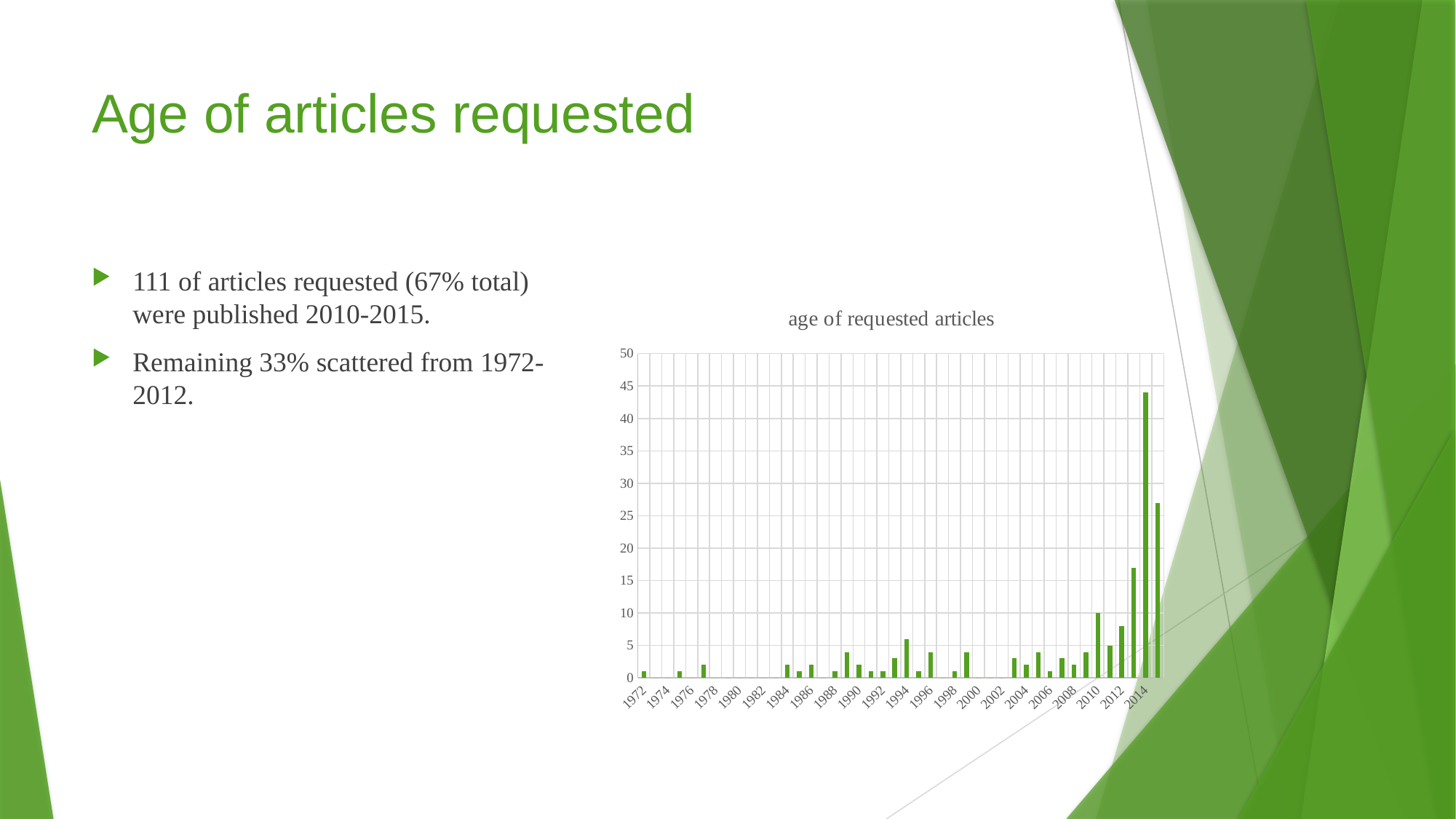
What kind of chart is shown on the slide? bar chart Which year has the highest number of requested articles? 2014 Is the value for 2013 greater or less than 15? greater What is the title of the chart? age of requested articles Do the values generally rise or fall as the years move from 1972 toward 2015? rise Is the value for 2015 greater or less than 25? greater Is the value for 2012 greater or less than 10? less Which is larger, the value for 2014 or the value for 2015? 2014 What is the highest value shown on the vertical axis? 50 Which is larger, the value for 2010 or the value for 2012? 2010